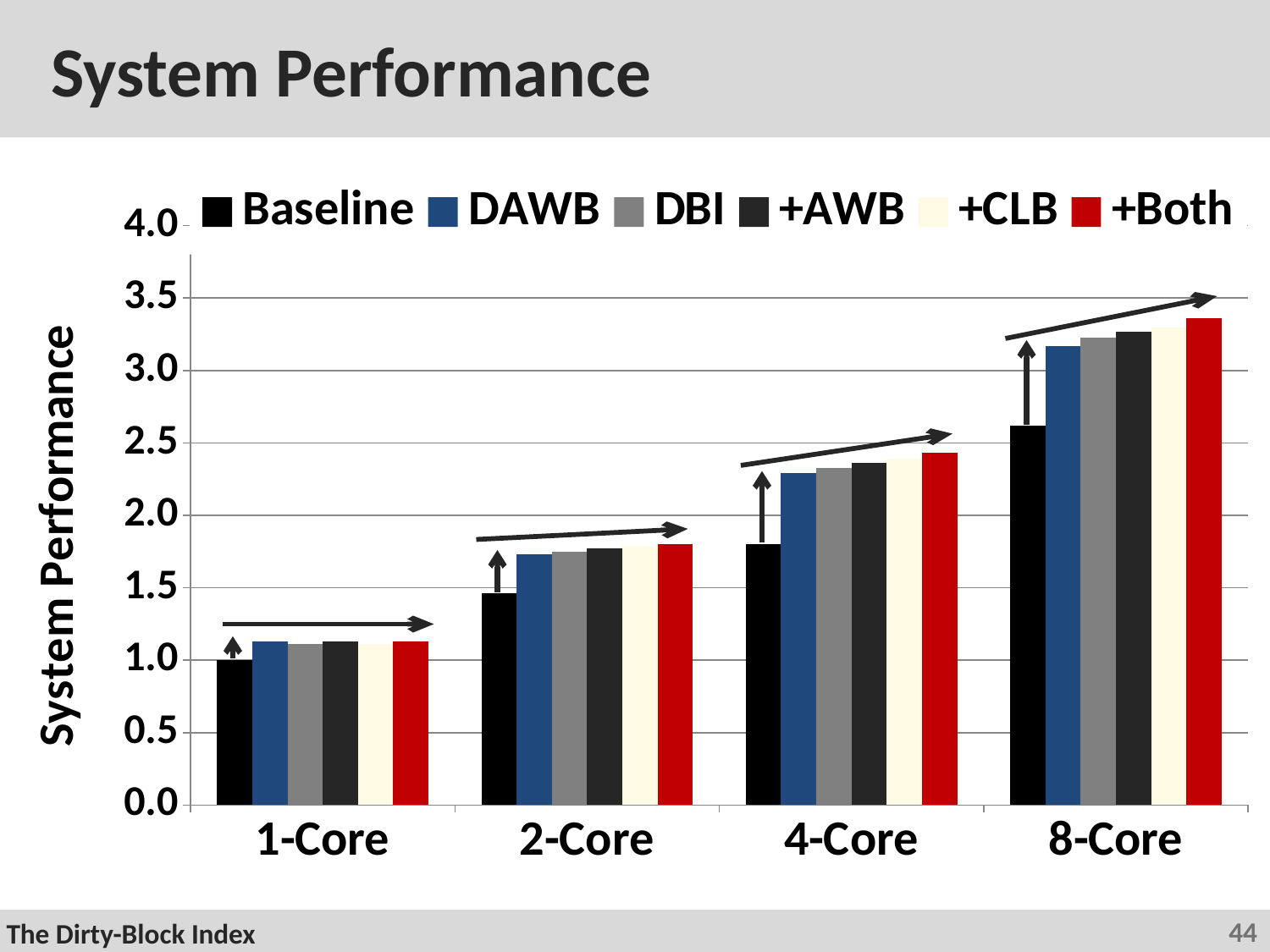
What is the Baseline value for 1-Core? 1.0 How many series does the legend list? 6 What kind of chart is shown on the slide? bar chart Which category has the lowest +Both value? 1-Core What is the label on the y axis? System Performance Is the Baseline value for 4-Core greater or less than 2.0? less Which category has the highest Baseline value? 8-Core How many categories are shown on the x axis? 4 Do the +Both values rise or fall from 1-Core to 8-Core? rise Is the +Both value for 8-Core greater or less than 3.5? less Which is larger: the Baseline value for 8-Core or the +Both value for 4-Core? Baseline for 8-Core Is the Baseline value for 8-Core greater or less than 2.5? greater